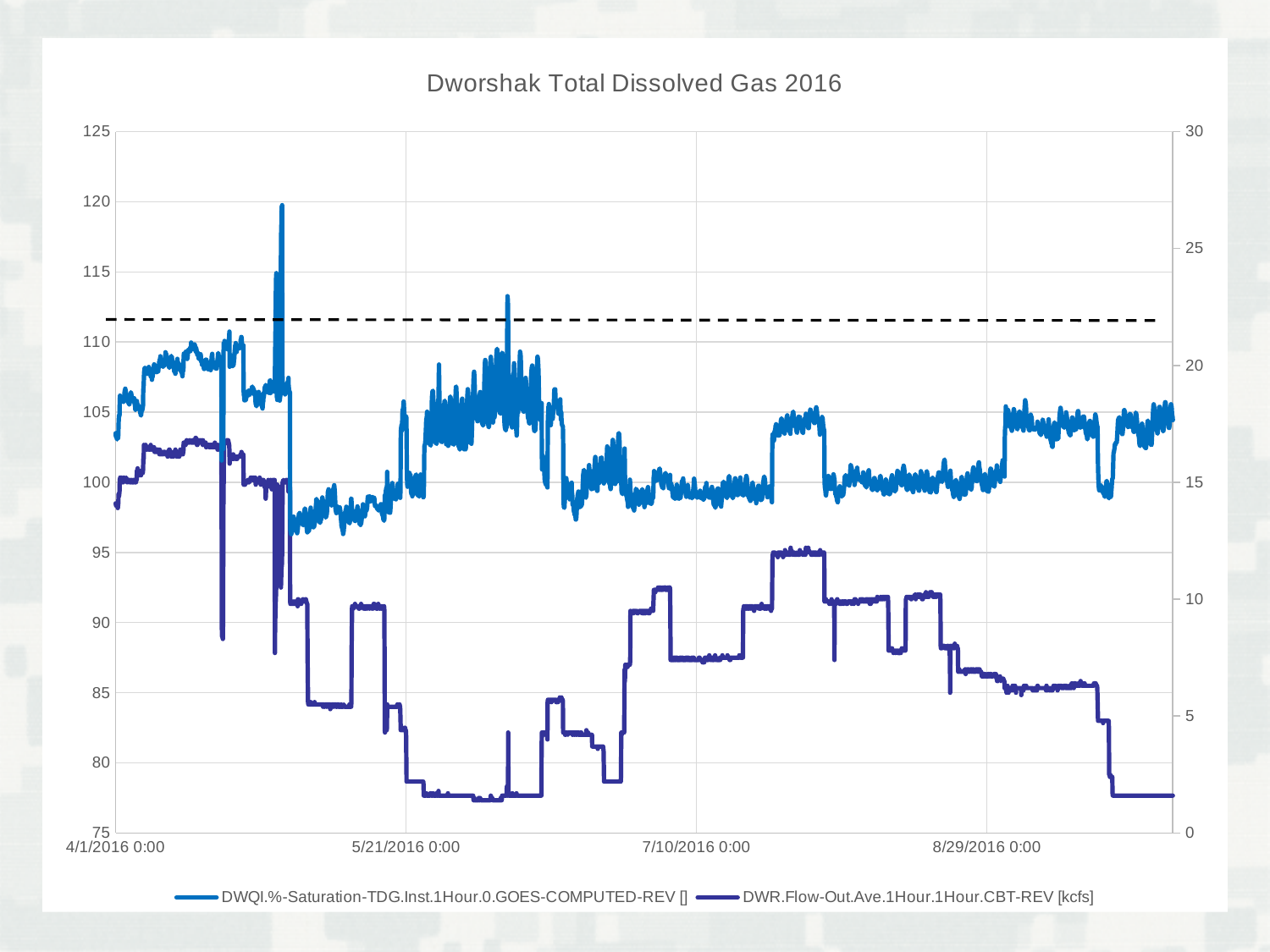
What is the maximum value shown on the left vertical axis? 125 Is the highest value of the DWR.Flow-Out series greater or less than 10 on the right axis? greater Is the dashed horizontal line above or below 110 on the left axis? above Does the DWR.Flow-Out series overall rise or fall from 4/1/2016 to the end of the period? fall What is the title of the chart? Dworshak Total Dissolved Gas 2016 How many series does the legend list? 2 What kind of chart is shown on the slide? line chart Is the peak value of the DWQI.%-Saturation-TDG series greater or less than 115 on the left axis? greater What unit is shown in the legend for the DWR.Flow-Out series? kcfs